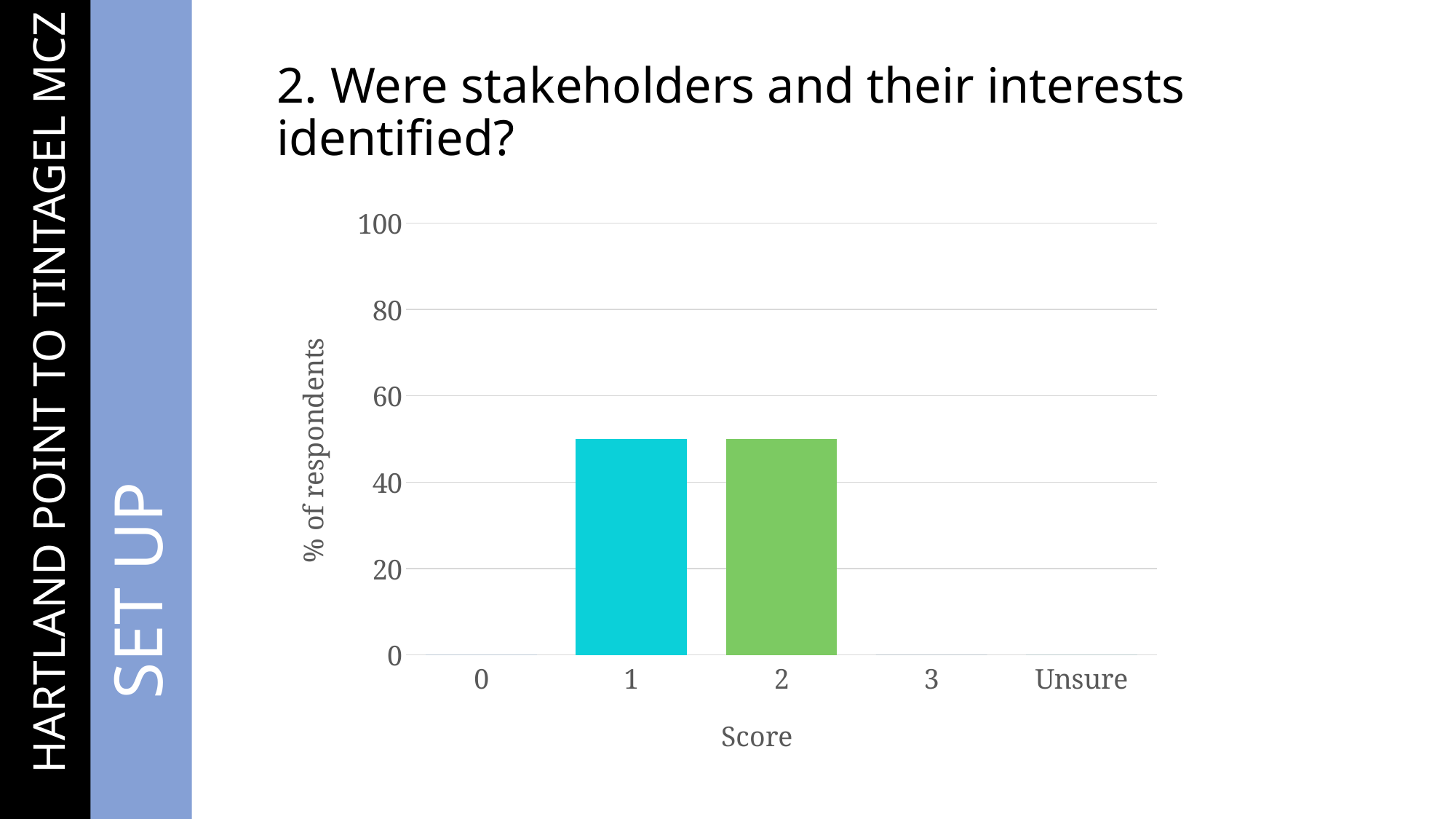
What is the label on the x axis of the chart? Score Is the value for Unsure greater or less than 20? less Which has the larger value, score 2 or Unsure? score 2 Is the value for score 1 greater or less than 60? less How many score categories are shown on the x axis of the chart? 5 What kind of chart is shown on the slide? bar chart Is the value for score 2 greater or less than 60? less Which has the larger value, score 1 or score 0? score 1 What is the label on the y axis of the chart? % of respondents